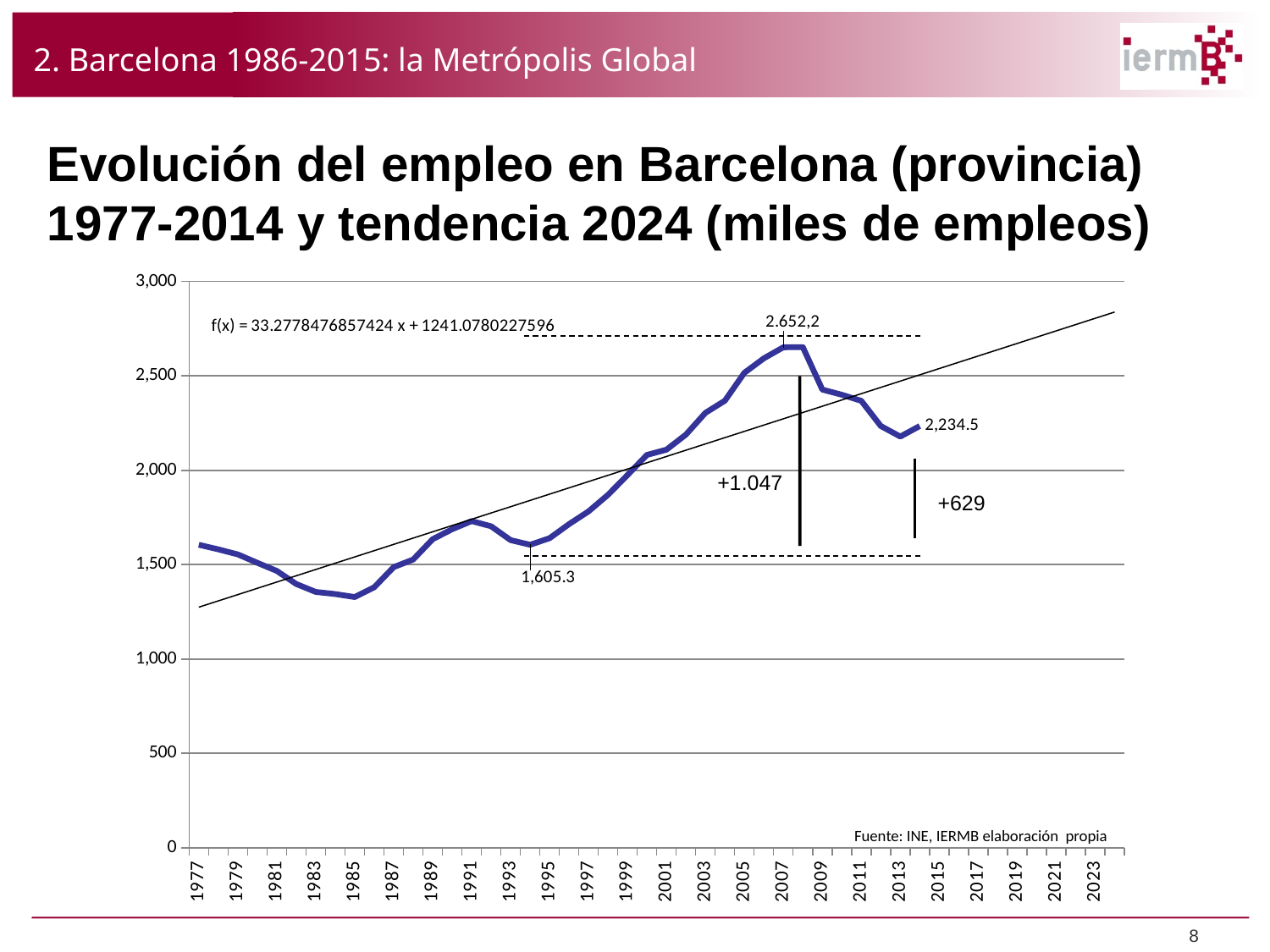
Is the employment value for 1985 greater or less than 1,500? less What is the labeled peak value of employment on the chart? 2.652,2 What is the trend line equation printed on the chart? f(x) = 33.2778476857424 x + 1241.0780227596 Is the employment value for 1977 greater or less than 1,500? greater Does the employment series rise or fall between 2008 and 2013? fall What is the labeled value at the end of the employment series (2014)? 2,234.5 What increase is annotated between the trough of 1,605.3 and the peak of 2.652,2? +1.047 Does the employment series rise or fall between 1995 and 2007? rise Is the employment value for 2001 greater or less than 2,000? greater What is the labeled lowest value of employment shown on the chart (around 1994)? 1,605.3 What kind of chart is shown on the slide? line chart What difference is annotated between the 2014 value of 2,234.5 and the trough of 1,605.3? +629